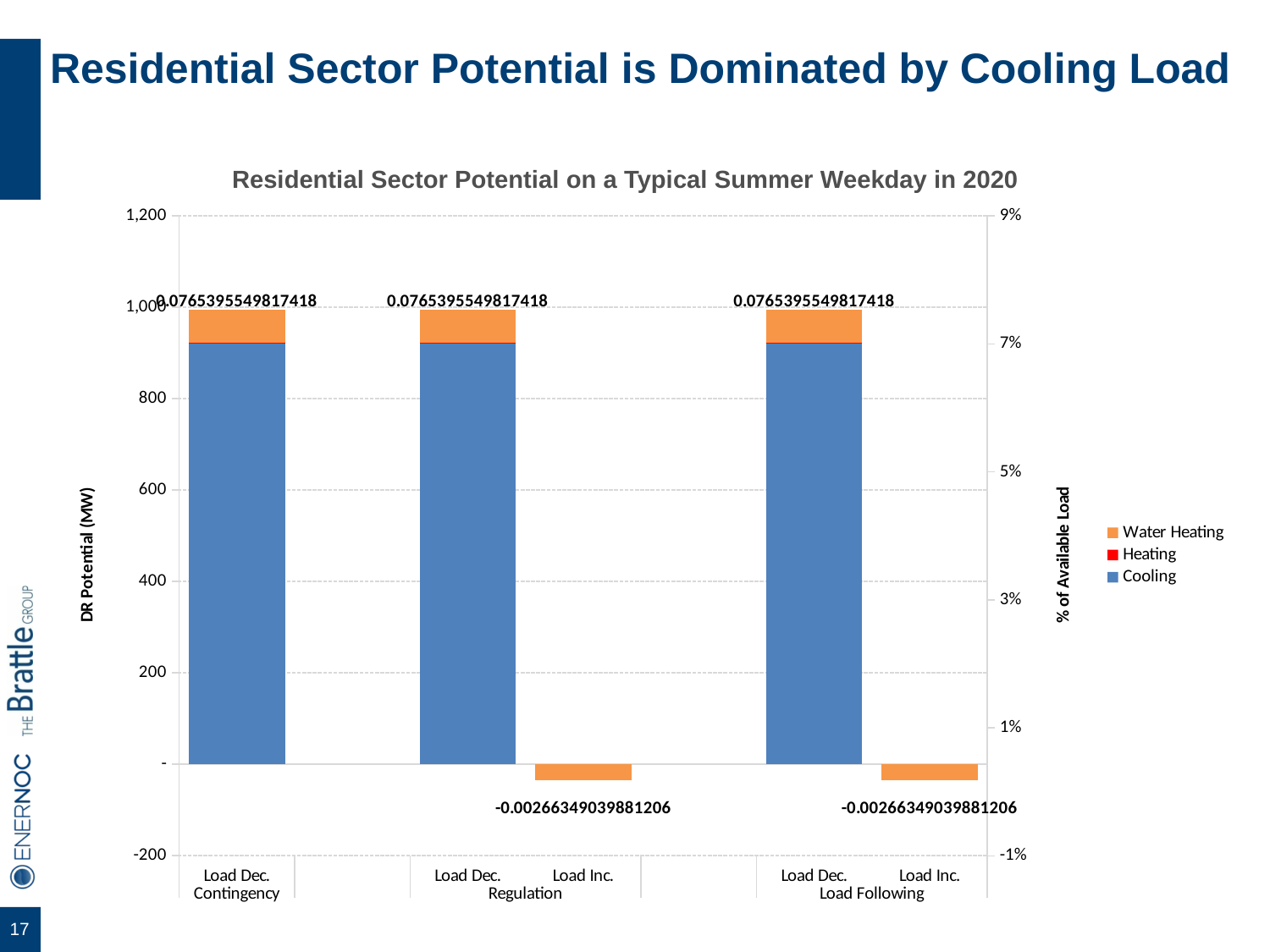
How many series does the legend list? 3 What data label is printed above the Load Dec. Load Following bar? 0.0765395549817418 What data label is printed above the Load Dec. Contingency bar? 0.0765395549817418 Which bar is taller, Load Dec. Regulation or Load Inc. Regulation? Load Dec. Regulation What kind of chart is shown on the slide? bar chart Is the value for Load Inc. Load Following greater or less than 200 MW? less Is the total height of the Load Dec. Contingency bar greater or less than 800 MW? greater Which series are listed in the legend? Water Heating, Heating, Cooling What is the title of the chart? Residential Sector Potential on a Typical Summer Weekday in 2020 How many bars are plotted in the chart? 5 Is the Cooling portion of the Load Dec. Regulation bar greater or less than 600 MW? greater What data label is printed below the Load Inc. Regulation bar? -0.00266349039881206